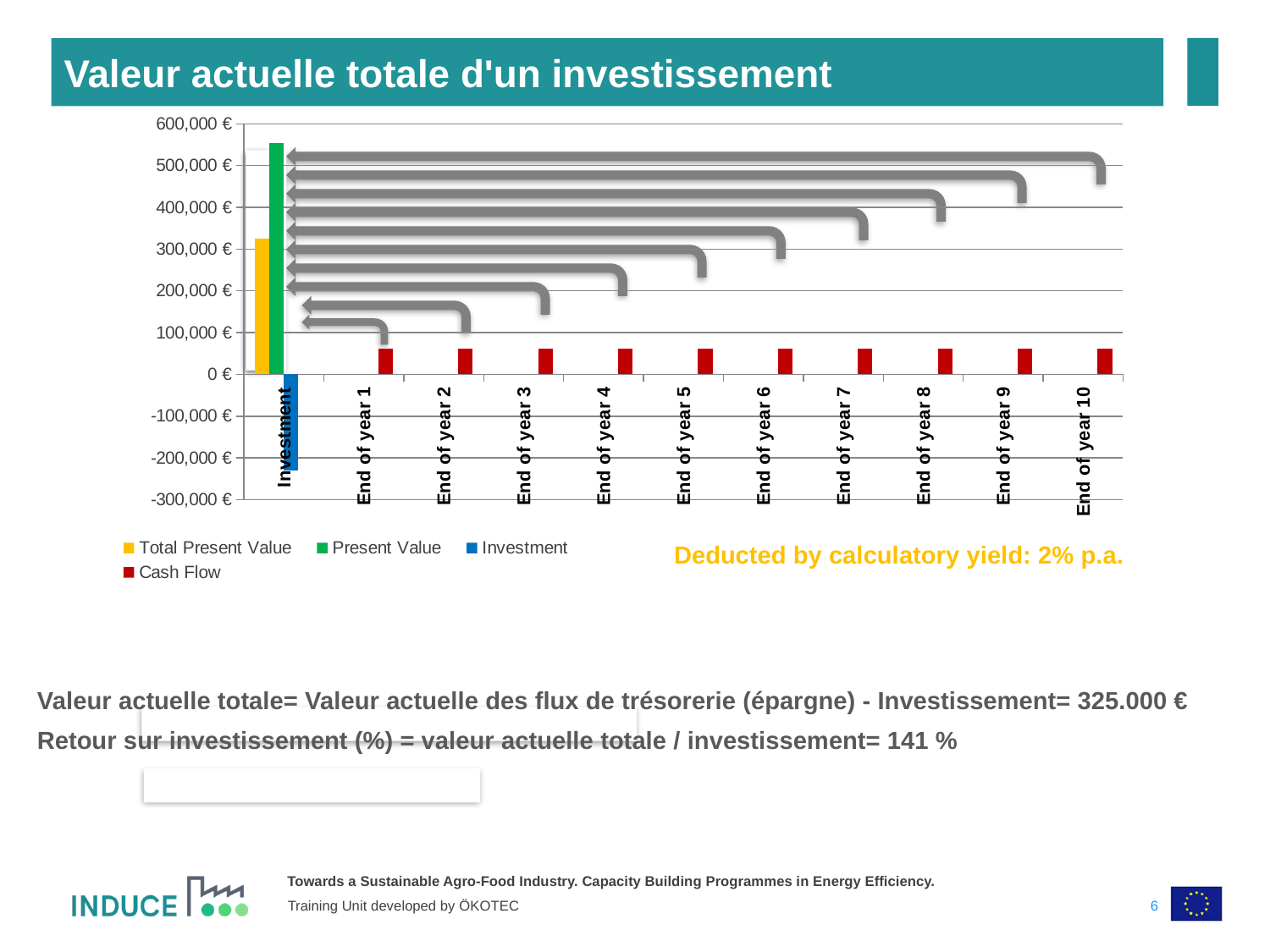
How many series does the chart legend list? 4 Which series has the lowest (most negative) bar in the chart? Investment What kind of chart is shown on the slide? bar chart How many categories are shown along the x axis of the chart? 11 What colour is used for the Cash Flow series in the chart? red Is the Cash Flow bar for End of year 1 greater or less than 100,000 €? less What calculatory yield is stated next to the chart legend? 2% p.a. Is the Present Value bar greater or less than 500,000 €? greater Which series has the tallest bar in the chart? Present Value Is the Investment bar greater or less than -200,000 €? less Which is larger, the Present Value bar or the Total Present Value bar? Present Value